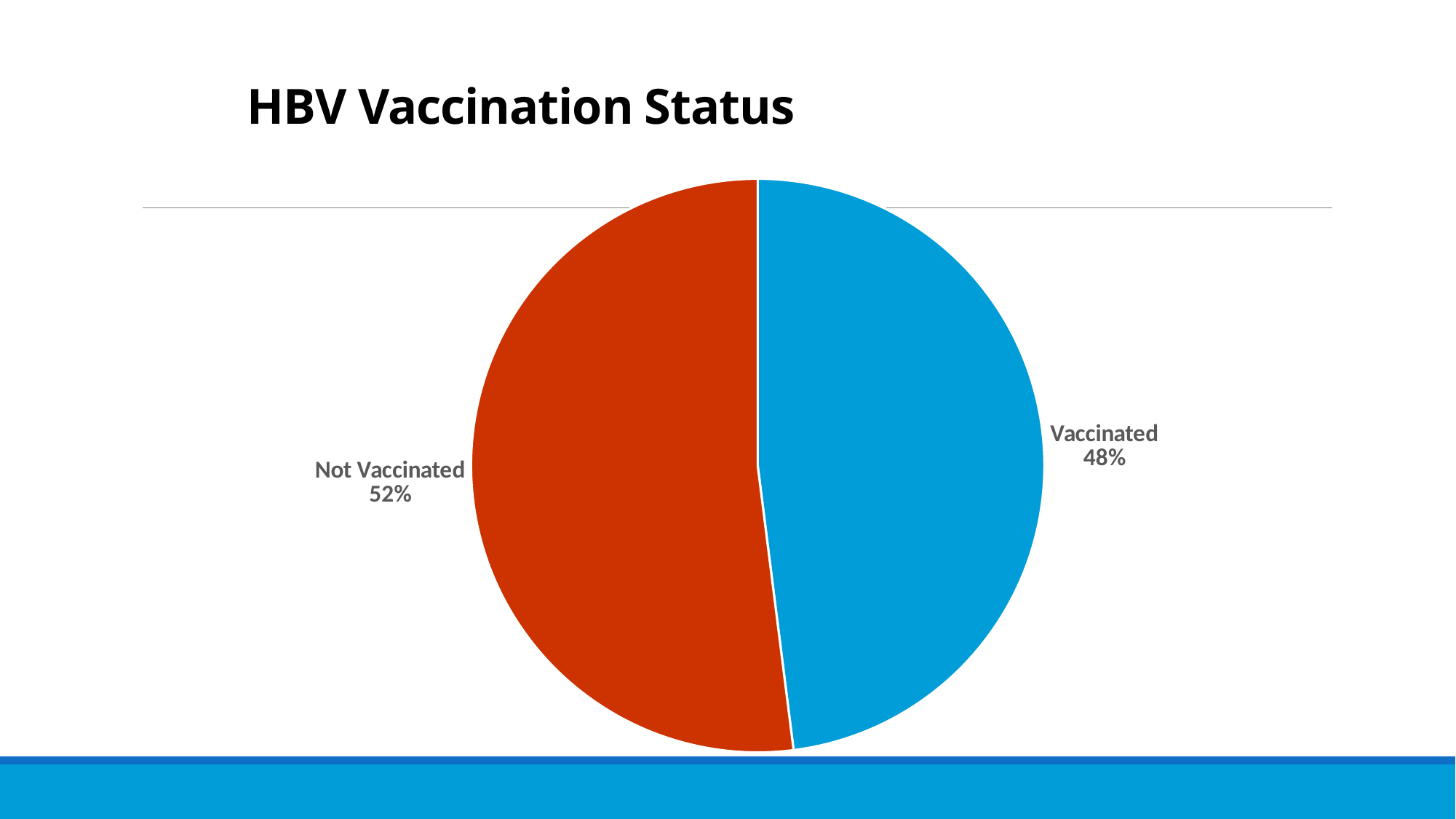
What percentage of the pie is labelled Not Vaccinated? 52% What is the difference in percentage points between Not Vaccinated and Vaccinated? 4 Which is larger, the Vaccinated slice or the Not Vaccinated slice? Not Vaccinated What share of the pie does the Vaccinated slice represent? 48% What colour is the Not Vaccinated slice? red Which slice is the smallest? Vaccinated What type of chart is shown on the slide? pie chart How many slices does the pie chart have? 2 Which slice is the largest? Not Vaccinated What percentage of the pie is labelled Vaccinated? 48% What is the title of the chart? HBV Vaccination Status